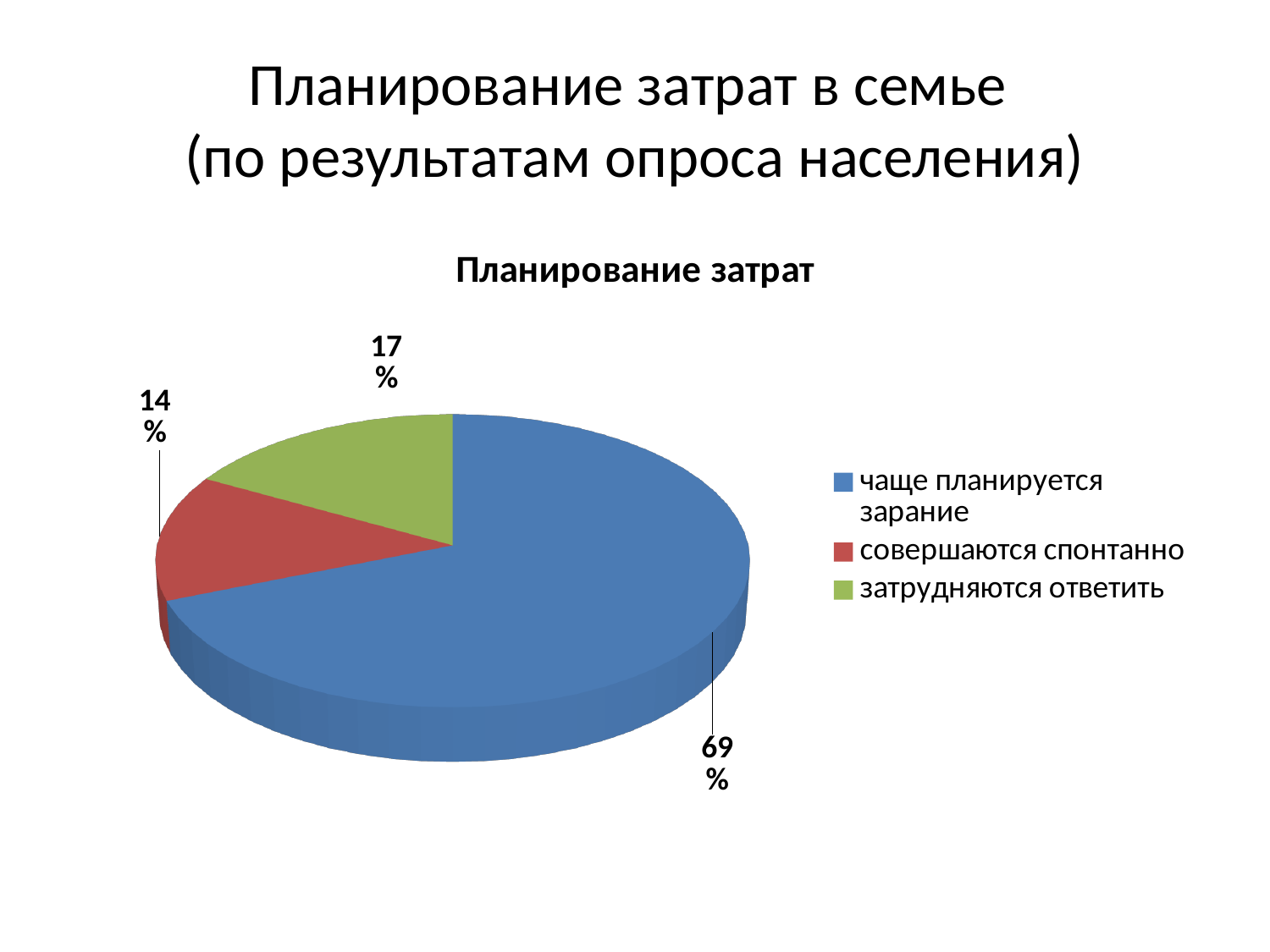
What share of the pie does "чаще планируется зарание" have? 69% Which is larger: the slice for "затрудняются ответить" or the slice for "совершаются спонтанно"? затрудняются ответить Which category has the largest slice of the pie? чаще планируется зарание What type of chart is shown on the slide? pie chart Which category has the smallest slice of the pie? совершаются спонтанно What is the difference in percentage points between "затрудняются ответить" and "совершаются спонтанно"? 3 What is the difference in percentage points between "чаще планируется зарание" and "затрудняются ответить"? 52 What colour is the slice for "совершаются спонтанно"? red What share of the pie does "затрудняются ответить" have? 17% How many categories does the pie chart show? 3 What share of the pie does "совершаются спонтанно" have? 14% What is the title of the chart? Планирование затрат